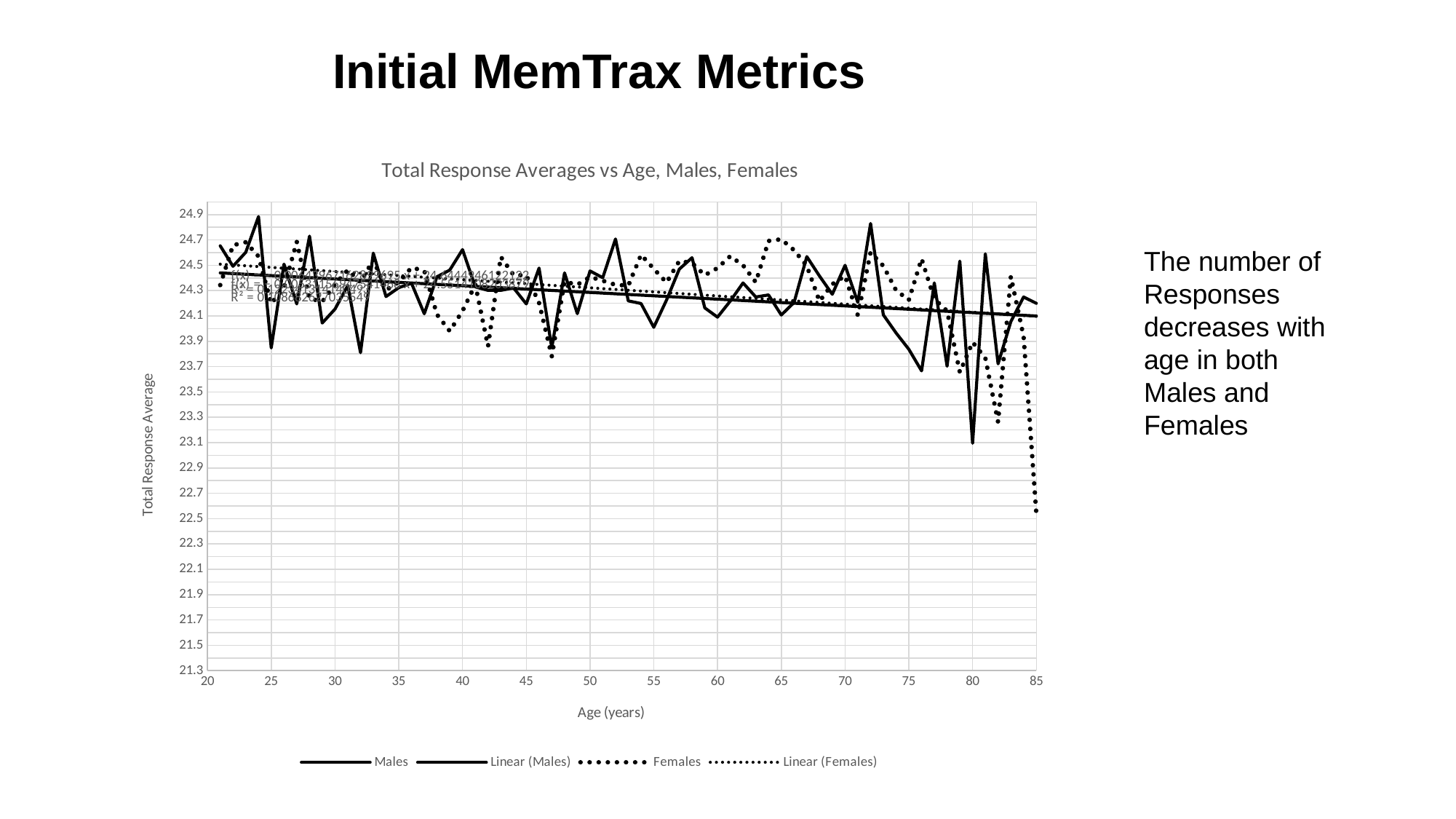
At which age does the Females series reach its lowest value? 85 What is the label of the x axis of the chart? Age (years) What is the title of the chart? Total Response Averages vs Age, Males, Females Is the Males value at age 80 greater or less than 23.5? less Do the Linear (Females) trend line values rise or fall as age increases? fall Is the Females value at age 85 greater or less than 23.1? less Is the Males value at age 72 greater or less than 24.7? greater At age 85, which series has the higher value, Males or Females? Males At age 80, which series has the higher value, Males or Females? Females What kind of chart is shown on the slide? line chart Do the Linear (Males) trend line values rise or fall as age increases? fall How many series does the chart legend list? 4